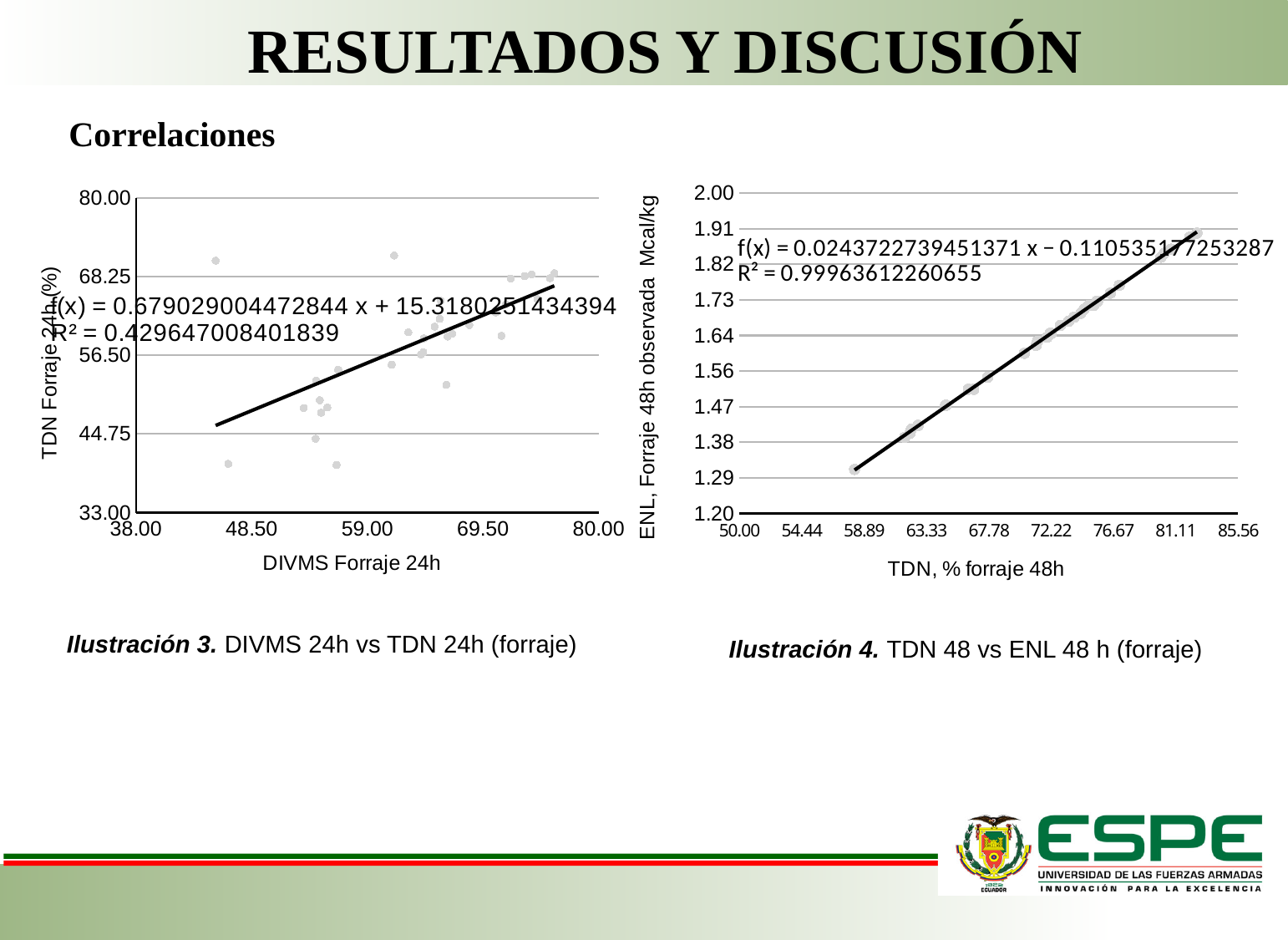
In Ilustración 4 (the right chart), what is the trendline equation shown? f(x) = 0.0243722739451371 x − 0.110535177253287 In Ilustración 3 (the left chart), what is the trendline equation shown? f(x) = 0.679029004472844 x + 15.3180251434394 What kind of chart is Ilustración 3 (the left chart)? Scatter chart with a trendline In Ilustración 4 (the right chart), what is the R² value shown? 0.99963612260655 In Ilustración 3 (the left chart), is the highest plotted point greater or less than 68.25 on the y axis? greater What kind of chart is Ilustración 4 (the right chart)? Scatter chart with a trendline In Ilustración 4 (the right chart), does ENL rise or fall as TDN increases along the x axis? Rises Which chart has the higher R² value, Ilustración 3 (left) or Ilustración 4 (right)? Ilustración 4 (right) What is the y-axis title of Ilustración 3 (the left chart)? TDN Forraje 24h (%) What is the x-axis title of Ilustración 4 (the right chart)? TDN, % forraje 48h In Ilustración 3 (the left chart), what is the R² value shown? 0.429647008401839 In Ilustración 3 (the left chart), does the trendline rise or fall as DIVMS Forraje 24h increases? Rises